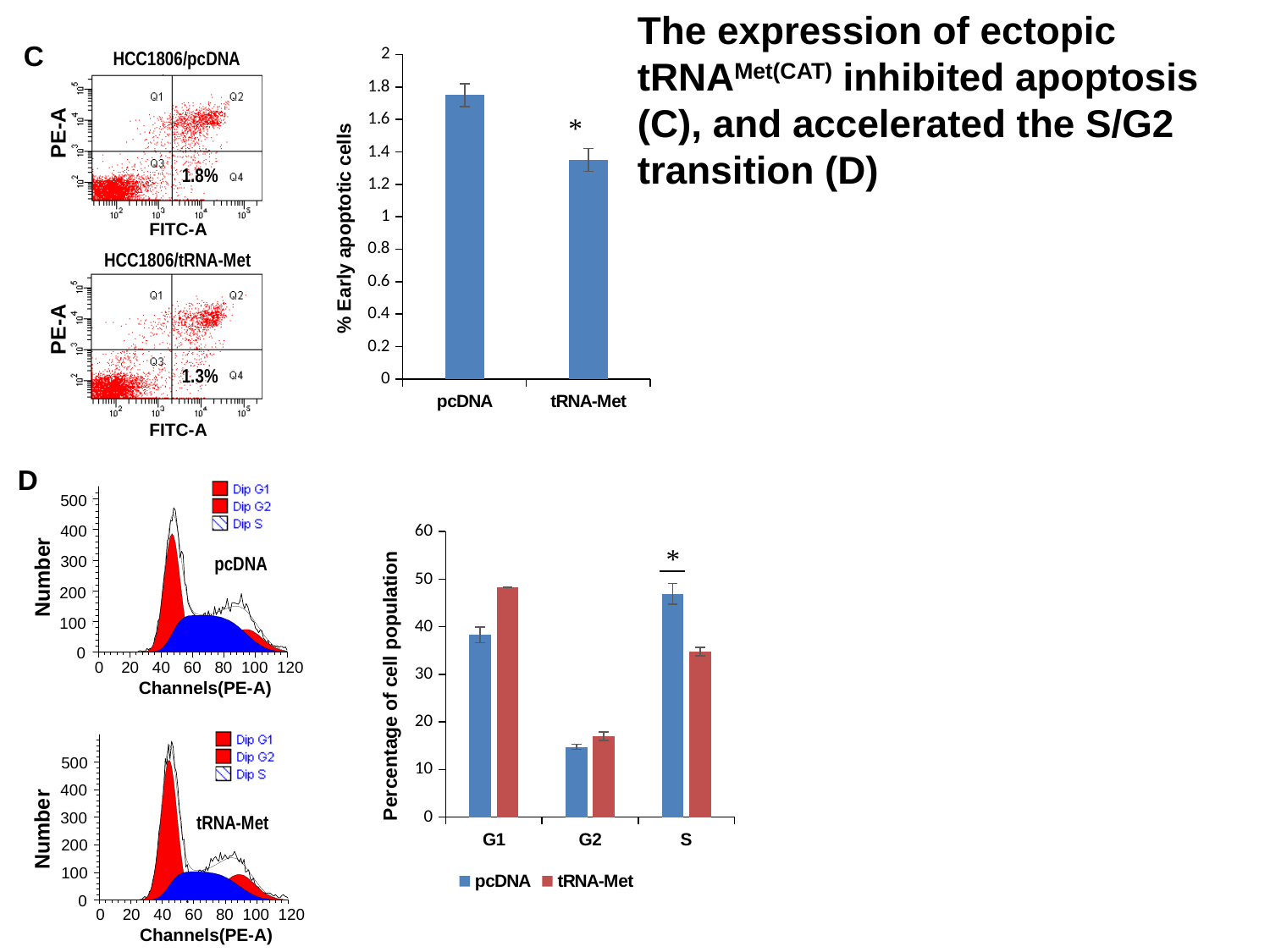
In the '% Early apoptotic cells' chart, is the value for pcDNA greater or less than 1.6? greater In the 'Percentage of cell population' chart, which phase has the lowest tRNA-Met value? G2 What kind of chart is the '% Early apoptotic cells' chart in panel C? bar chart In the 'Percentage of cell population' chart, for the S phase, which series is larger, pcDNA or tRNA-Met? pcDNA In the 'Percentage of cell population' chart, is the tRNA-Met value for G1 greater or less than 40? greater In the 'Percentage of cell population' chart, what colour are the tRNA-Met bars? red How many bars are plotted in the '% Early apoptotic cells' chart? 2 How many series does the legend of the 'Percentage of cell population' chart list? 2 In the 'Percentage of cell population' chart, which phase has the highest pcDNA value? S In the '% Early apoptotic cells' chart, is the value for tRNA-Met greater or less than 1.2? greater In the '% Early apoptotic cells' chart, which group has the higher value, pcDNA or tRNA-Met? pcDNA How many cell-cycle phase categories are shown on the x axis of the 'Percentage of cell population' chart? 3